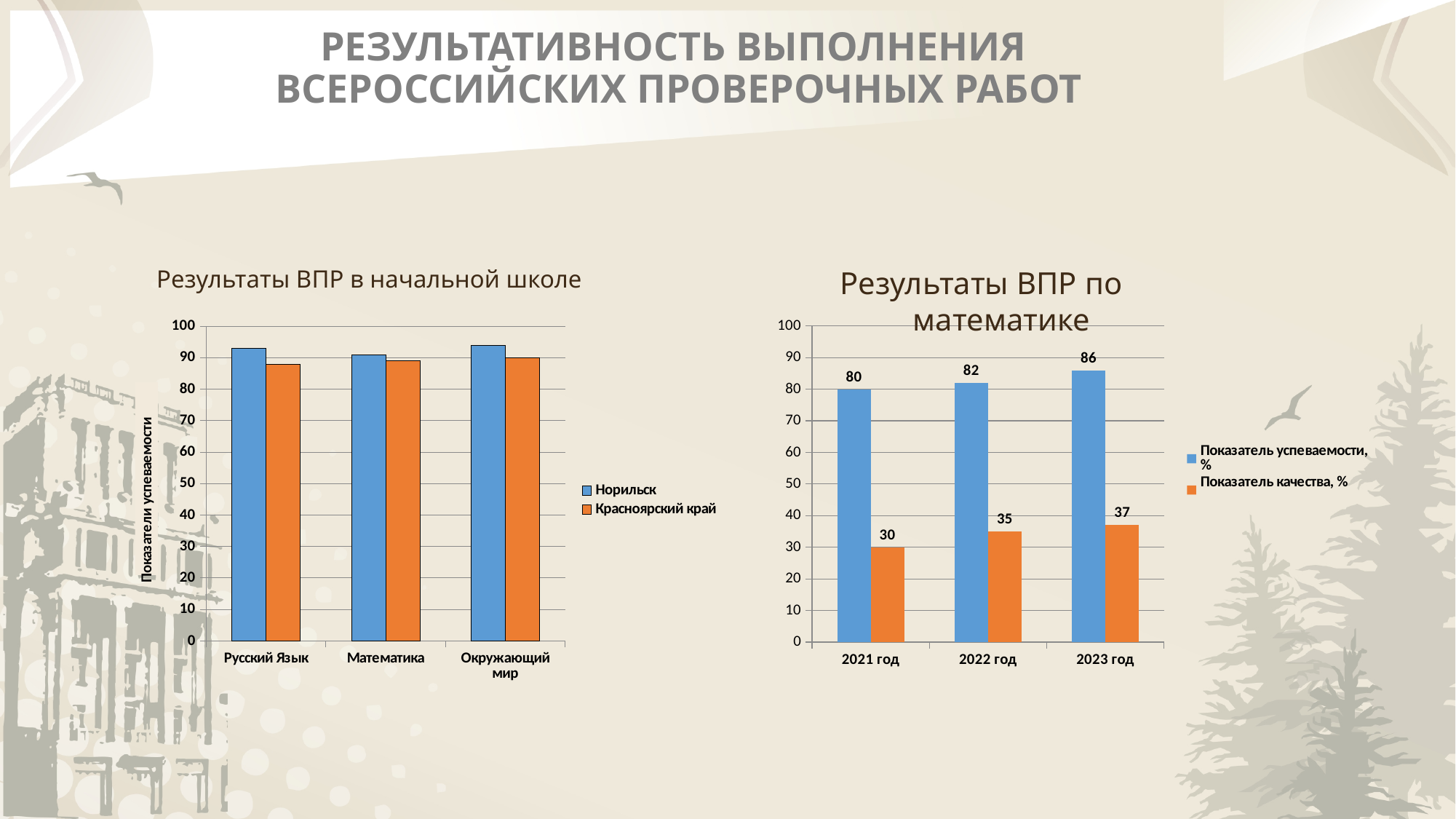
In the chart titled "Результаты ВПР по математике", what is the value of "Показатель качества, %" for 2021 год? 30 In the chart titled "Результаты ВПР в начальной школе", is the value for Норильск in Русский Язык greater or less than 90? greater In the chart titled "Результаты ВПР по математике", which year has the highest "Показатель качества, %"? 2023 год In the chart titled "Результаты ВПР в начальной школе", which is larger for Русский Язык: Норильск or Красноярский край? Норильск In the chart titled "Результаты ВПР по математике", which year has the lowest "Показатель успеваемости, %"? 2021 год In the chart titled "Результаты ВПР по математике", does "Показатель качества, %" rise or fall from 2021 год to 2023 год? rise In the chart titled "Результаты ВПР по математике", what is the value of "Показатель успеваемости, %" for 2023 год? 86 In the chart titled "Результаты ВПР в начальной школе", how many subject categories are shown on the x axis? 3 In the chart titled "Результаты ВПР в начальной школе", is the value for Красноярский край in Русский Язык greater or less than 90? less What kind of chart is "Результаты ВПР в начальной школе"? bar chart In the chart titled "Результаты ВПР по математике", what is the difference between "Показатель успеваемости, %" and "Показатель качества, %" for 2022 год? 47 In the chart titled "Результаты ВПР по математике", how many series does the legend list? 2